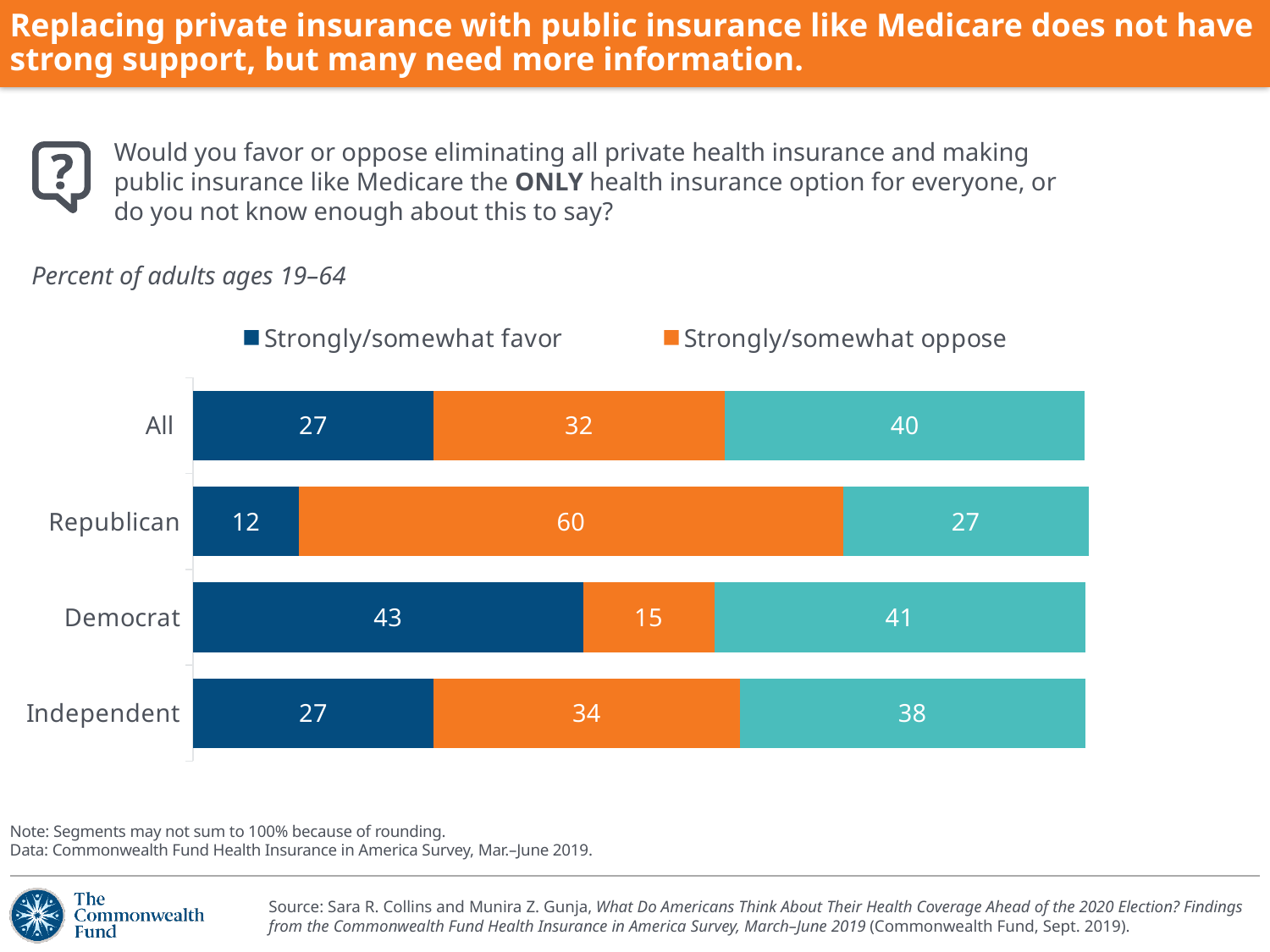
Which group has the lowest Strongly/somewhat oppose value? Democrat What is the difference between the Strongly/somewhat oppose values for Republicans and Democrats? 45 Which group has the lowest Strongly/somewhat favor value? Republican What percentage of Democrats strongly/somewhat favor eliminating private health insurance? 43 Which is larger: the Strongly/somewhat favor value for All or for Republicans? All What kind of chart is shown on the slide? Stacked bar chart What percentage of Republicans strongly/somewhat oppose eliminating private health insurance? 60 What is the total of the three segments in the Republican bar? 99 How many series does the legend list? 2 What is the Strongly/somewhat oppose value for Independents? 34 How many groups are shown on the vertical axis of the chart? 4 Which group has the highest Strongly/somewhat favor value? Democrat